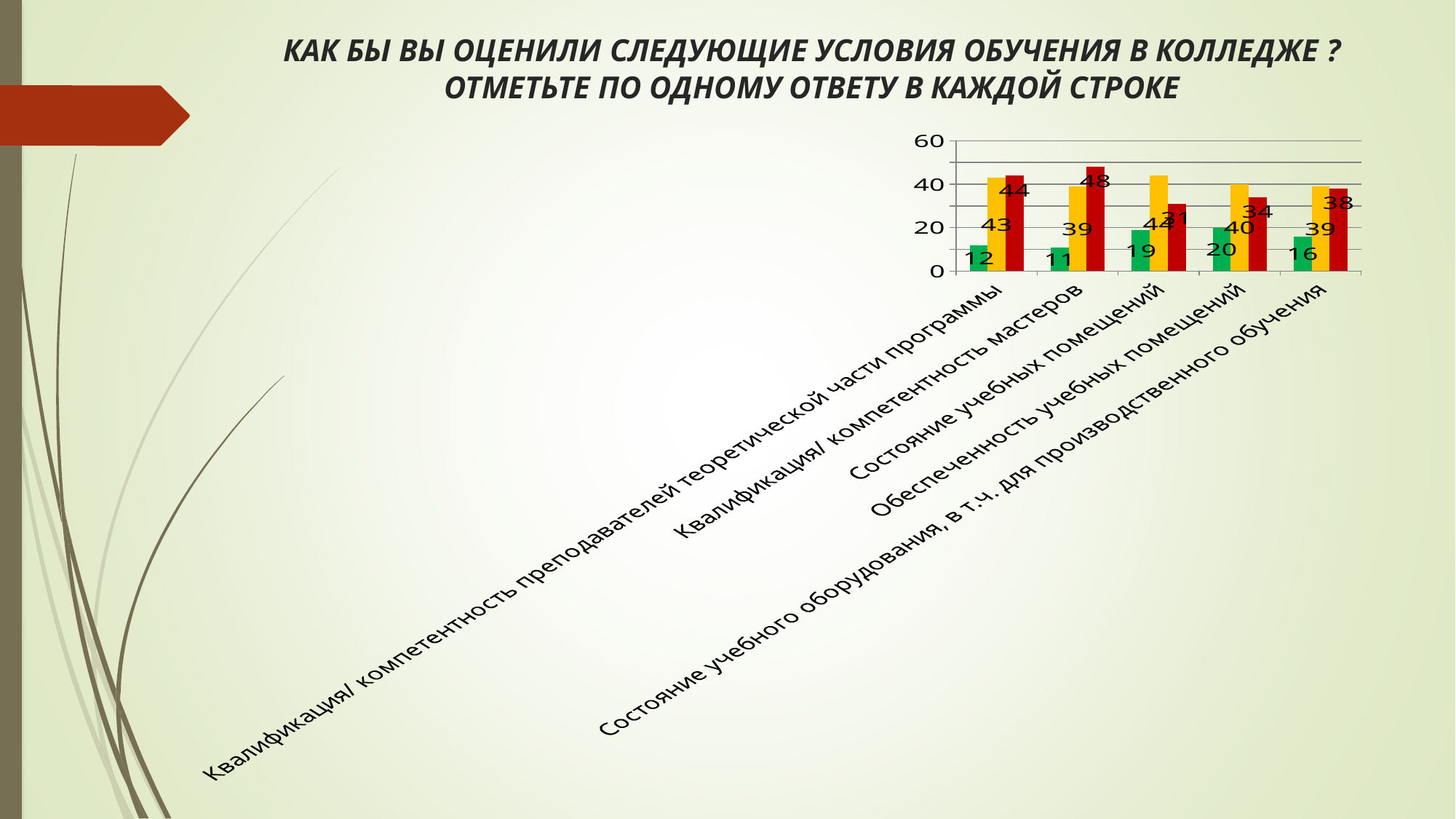
What is the value of the yellow bar for "Состояние учебных помещений"? 44 For "Состояние учебных помещений", which is larger: the yellow bar or the red bar? the yellow bar Which category has the highest red bar? Квалификация/ компетентность мастеров What is the value of the red bar for "Квалификация/ компетентность мастеров"? 48 Which category has the lowest green bar? Квалификация/ компетентность мастеров What kind of chart is shown on the slide? bar chart What is the value of the green bar for "Квалификация/ компетентность мастеров"? 11 How many bars are shown for each category in the chart? 3 What is the value of the green bar for "Обеспеченность учебных помещений"? 20 What is the difference between the red bar and the green bar for "Квалификация/ компетентность мастеров"? 37 How many categories are shown on the x axis of the chart? 5 Which category has the highest green bar? Обеспеченность учебных помещений